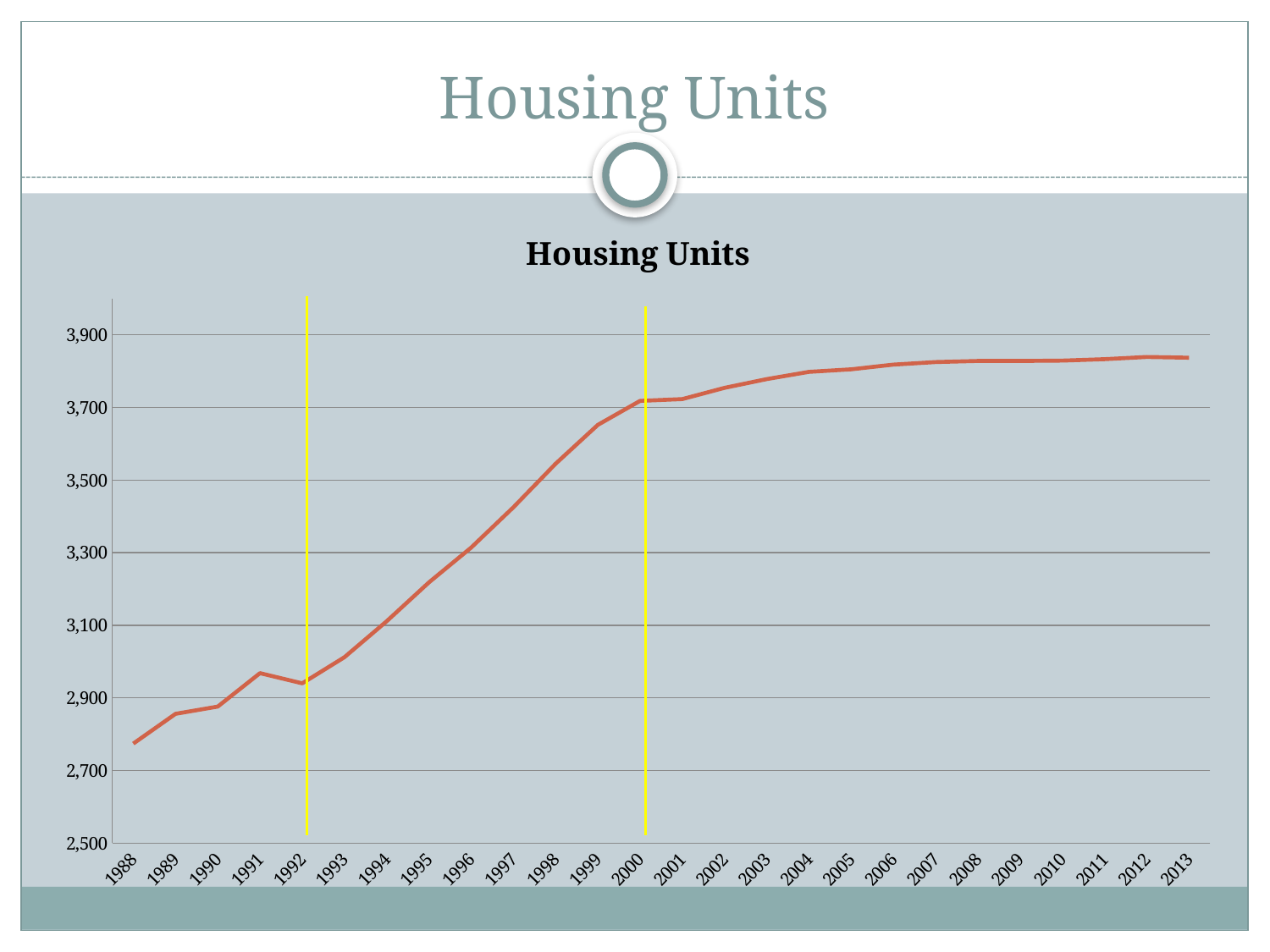
Is the value for 2013 greater or less than 3,900? less Do housing units generally rise or fall from 1988 to 2013? rise How many years are plotted along the x axis? 26 What kind of chart is shown on the slide? line chart What is the title of the chart? Housing Units Which year has more housing units, 1991 or 1992? 1991 Which year has the lowest number of housing units? 1988 Is the value for 1999 greater or less than 3,700? less Is the value for 1988 greater or less than 2,900? less How many yellow vertical marker lines are drawn on the chart? 2